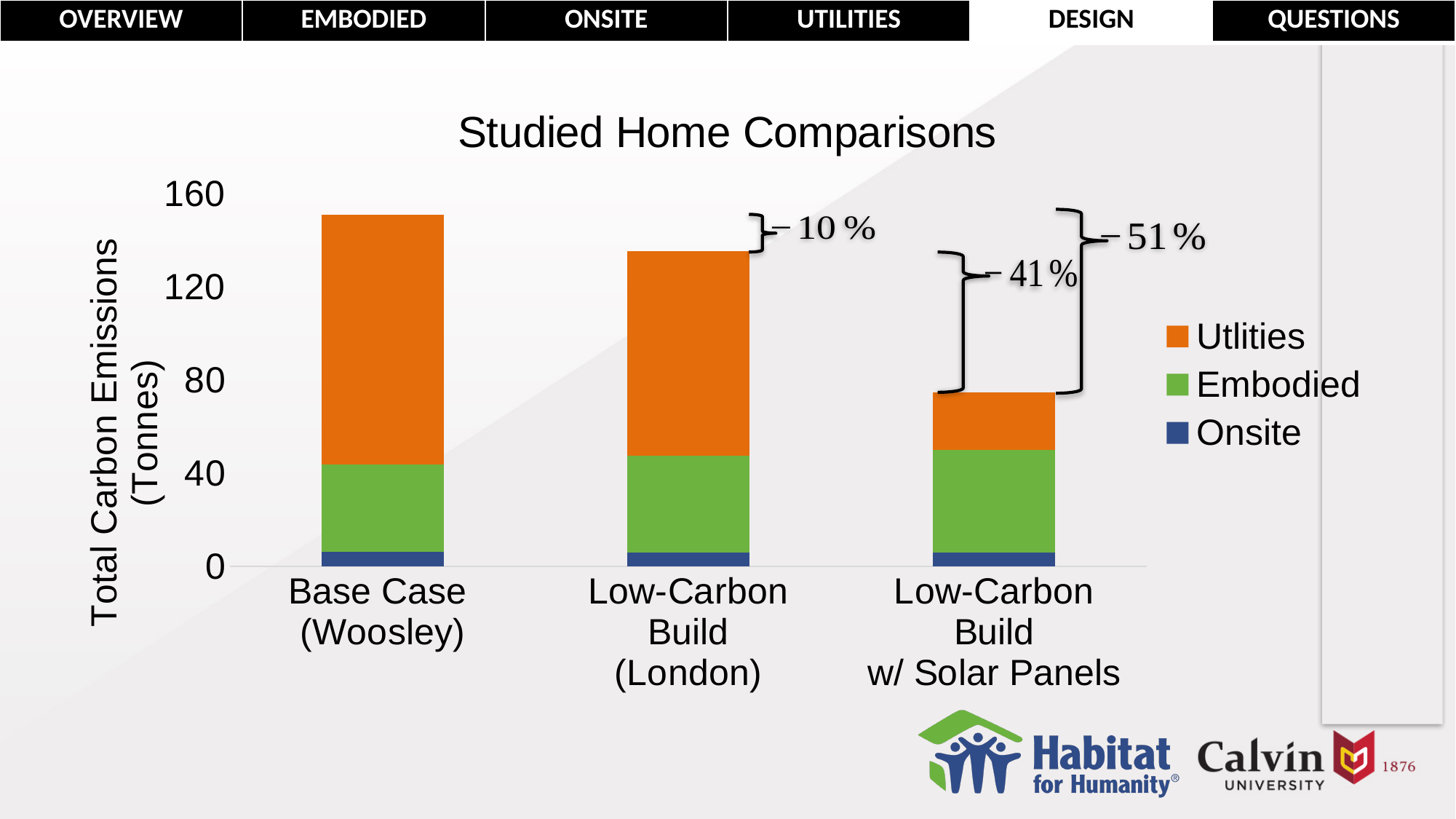
Which has higher total emissions, Base Case (Woosley) or Low-Carbon Build (London)? Base Case (Woosley) Which category has the lowest total carbon emissions? Low-Carbon Build w/ Solar Panels What is the title of the chart? Studied Home Comparisons Which category has the highest total carbon emissions? Base Case (Woosley) How many home categories are plotted on the x axis? 3 What percentage change is annotated for Low-Carbon Build (London) relative to the Base Case? -10 % Is the total for Low-Carbon Build (London) greater or less than 120? greater Is the total for Base Case (Woosley) greater or less than 140? greater What percentage change is annotated for Low-Carbon Build w/ Solar Panels relative to the Base Case? -51 % How many series does the legend list? 3 Is the total for Low-Carbon Build w/ Solar Panels greater or less than 120? less What kind of chart is shown on the slide? stacked bar chart